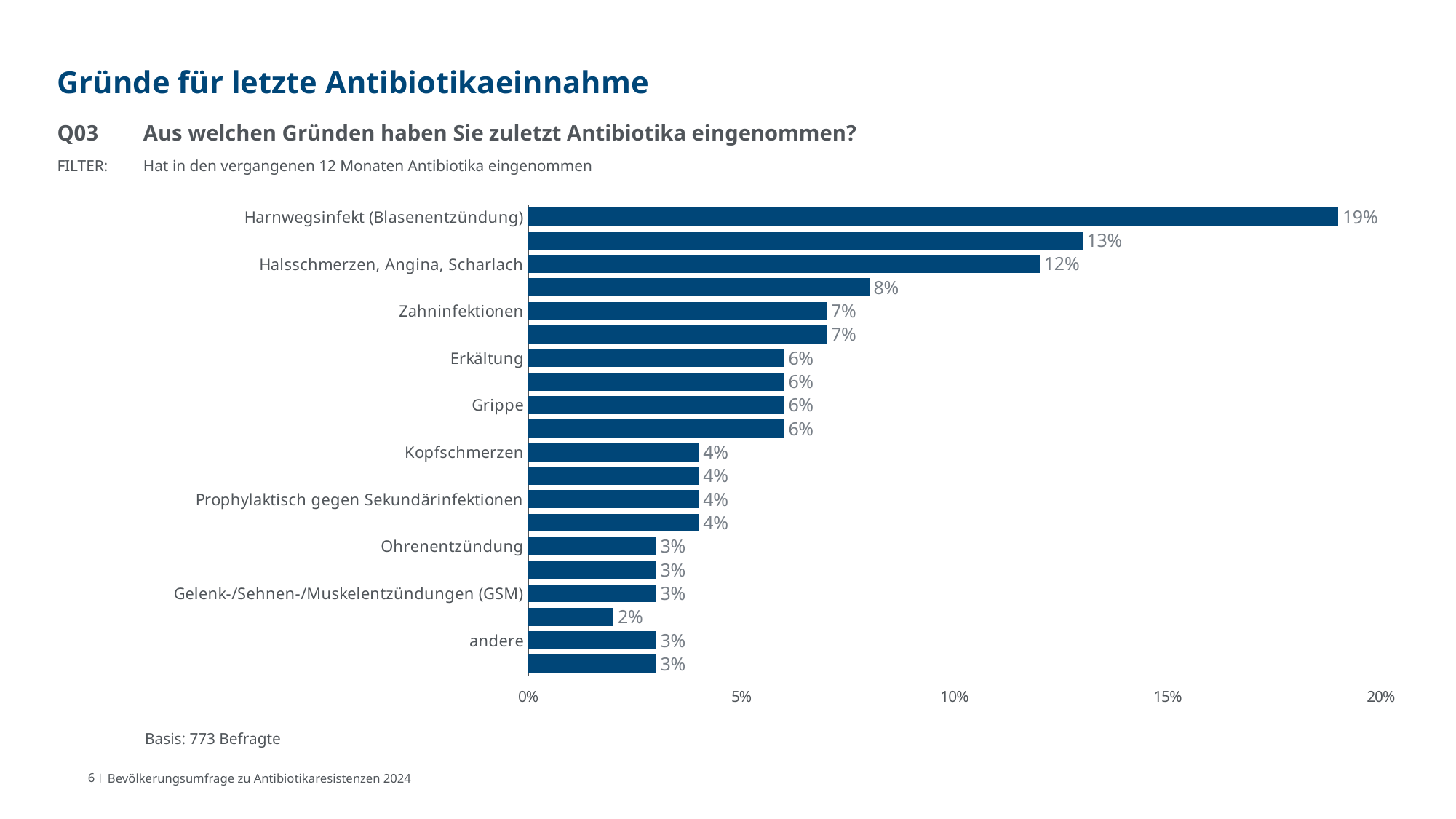
What is the value for Halsschmerzen, Angina, Scharlach? 12% Which labelled category has the highest value? Harnwegsinfekt (Blasenentzündung) How many respondents form the basis of the chart, according to the note below it? 773 Befragte Which is larger, the value for Erkältung or the value for Kopfschmerzen? Erkältung What is the value for Zahninfektionen? 7% What is the value for Ohrenentzündung? 3% Is the value for Harnwegsinfekt (Blasenentzündung) greater or less than 15%? greater What is the difference between the values for Harnwegsinfekt (Blasenentzündung) and Halsschmerzen, Angina, Scharlach? 7% What kind of chart is shown on the slide? bar chart What is the value for Kopfschmerzen? 4% What is the smallest value shown on any bar in the chart? 2% What is the value for Harnwegsinfekt (Blasenentzündung)? 19%